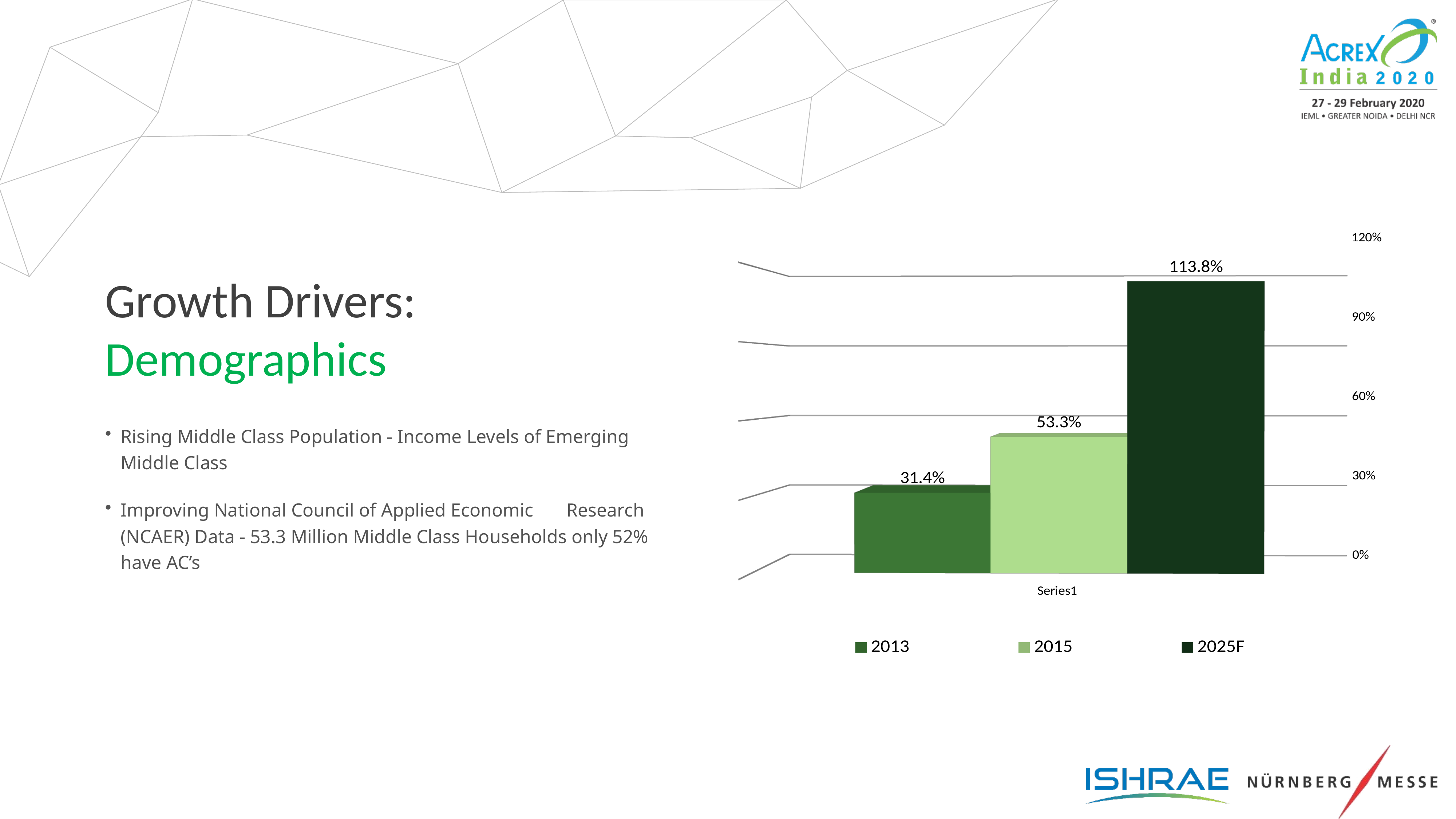
What is the value for 2013? 31.4% What is the difference between the 2015 value and the 2013 value? 21.9% Which series has the lowest value? 2013 Which series has the highest value? 2025F What is the difference between the 2025F value and the 2015 value? 60.5% What is the category label shown on the x axis of the chart? Series1 Is the value for 2025F greater or less than 90%? greater Which is larger, the value for 2013 or the value for 2015? 2015 What kind of chart is shown on the slide? bar chart What is the value for 2015? 53.3% How many series does the legend list? 3 What is the value for 2025F? 113.8%